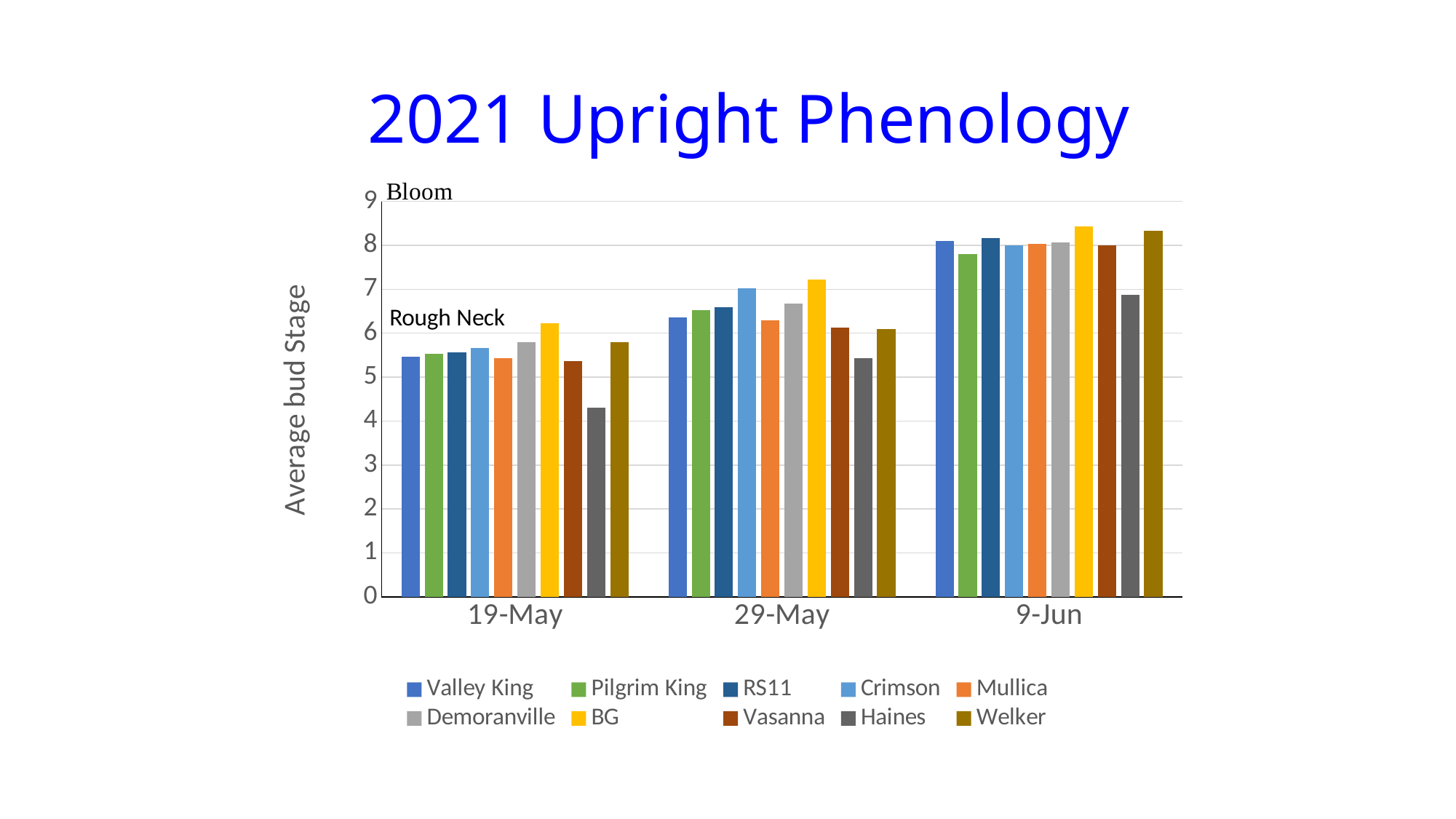
Which variety has the lowest average bud stage on 19-May? Haines How many series does the legend list? 10 Which variety has the highest average bud stage on 19-May? BG On 29-May, which is larger: the value for Crimson or the value for Mullica? Crimson What kind of chart is shown on the slide? bar chart Which variety has the highest average bud stage on 29-May? BG Is the value for Haines on 19-May greater or less than 5? less Does the average bud stage for Haines rise or fall from 19-May to 9-Jun? rise Is the value for BG on 29-May greater or less than 7? greater What is the title of the y axis? Average bud Stage How many dates are shown on the x axis? 3 Which variety has the lowest average bud stage on 9-Jun? Haines